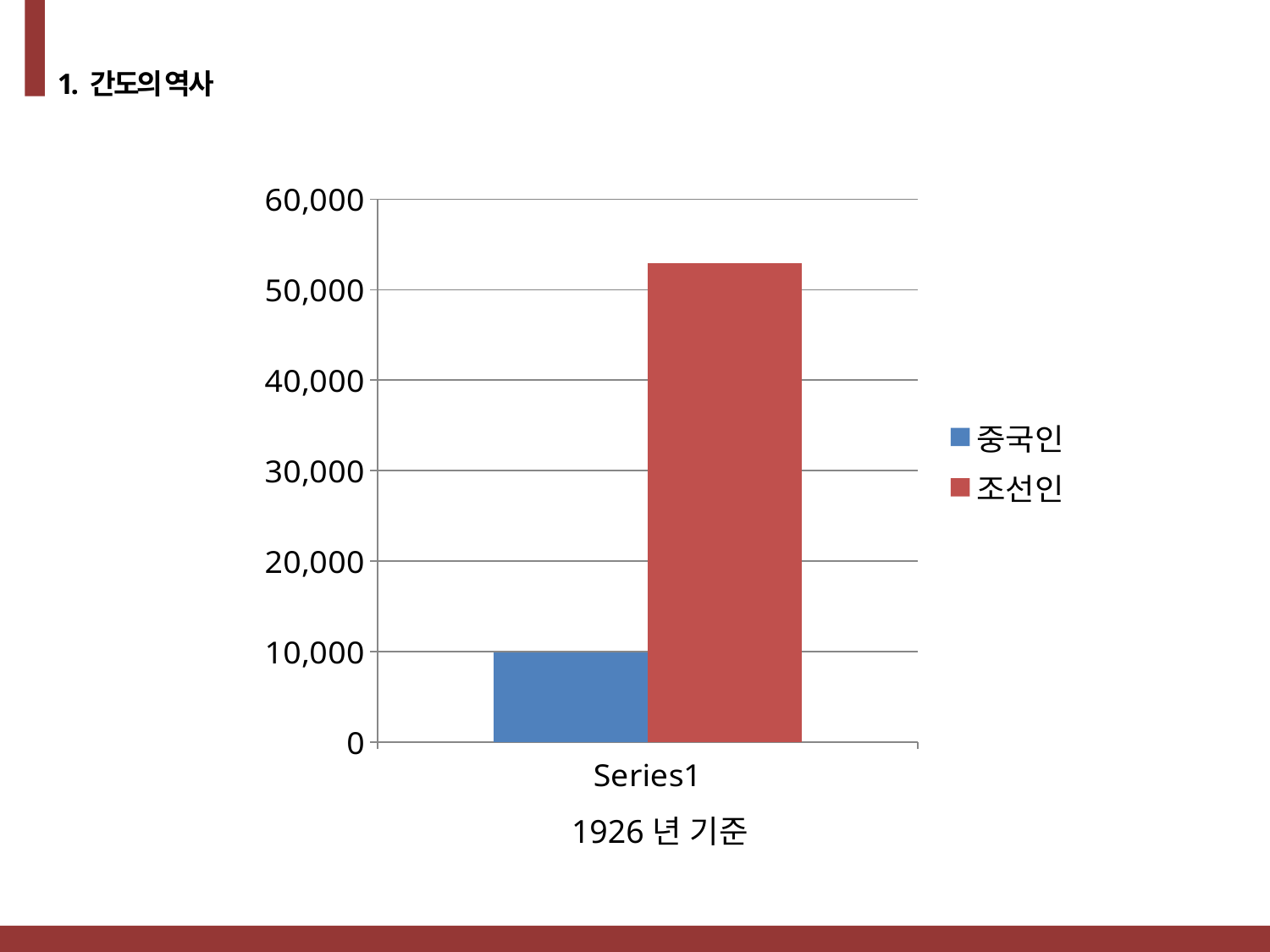
How many categories are shown on the x axis? 1 Which series has the higher value, 중국인 or 조선인? 조선인 How many series does the legend list? 2 What kind of chart is shown on the slide? bar chart Which series has the lowest value? 중국인 Is the value for 조선인 greater or less than 50,000? greater Which series has the highest value? 조선인 What are the two entries in the legend? 중국인, 조선인 What colour is the bar for 조선인? red Is the value for 중국인 greater or less than 20,000? less Is the value for 조선인 greater or less than 60,000? less